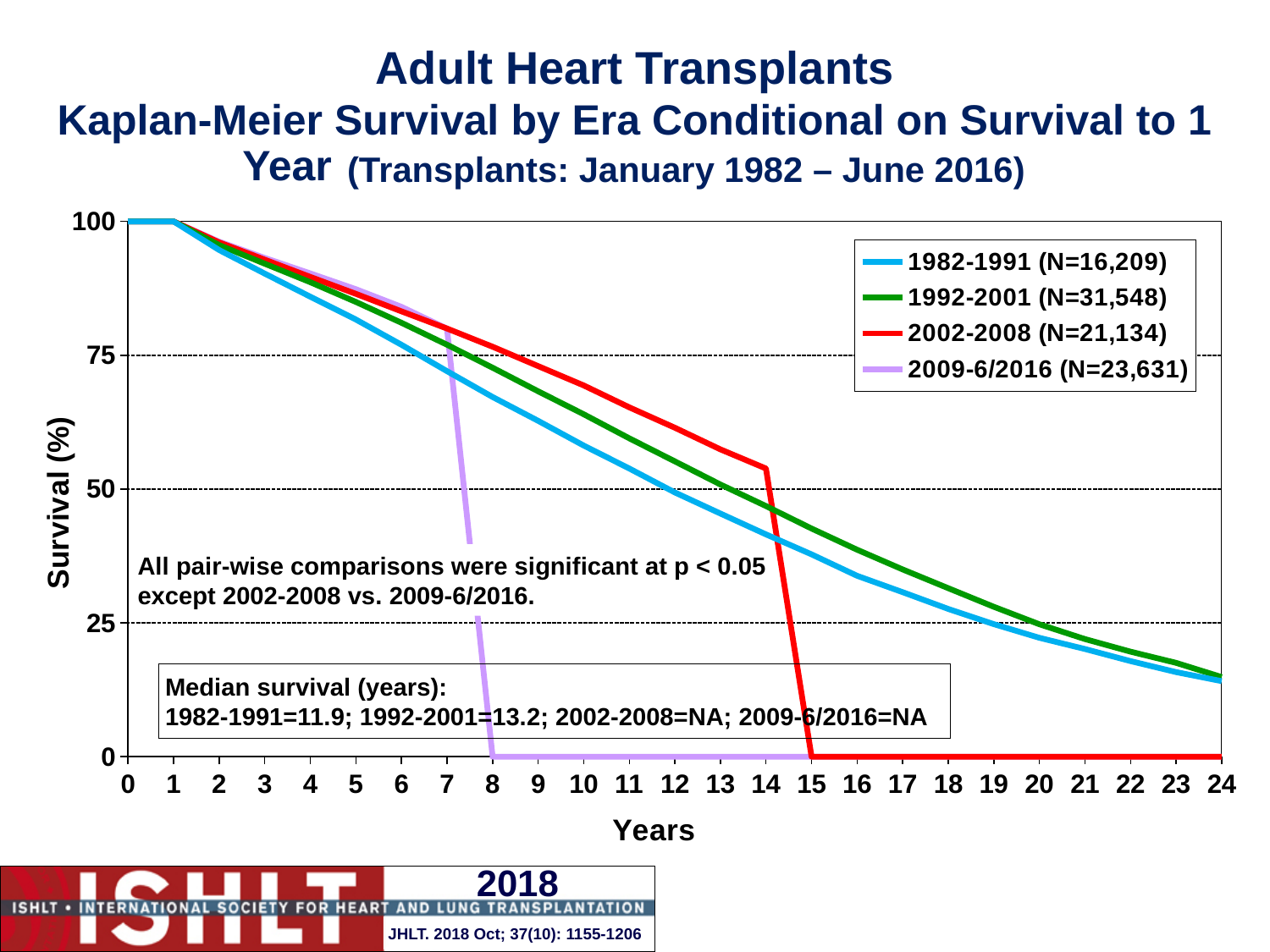
Which era has the largest N in the legend? 1992-2001 (N=31,548) Do the survival curves rise or fall as years increase? fall Is the survival for the 1982-1991 era at year 10 greater or less than 50? greater What is the difference in median survival (years) between the 1992-2001 and 1982-1991 eras? 1.3 According to the legend, what is the N for the 1992-2001 era? N=31,548 What is the median survival listed for the 2002-2008 era? NA At year 5, which era has higher survival, 1982-1991 or 2002-2008? 2002-2008 What kind of chart is shown on the slide? line chart What is the median survival in years for the 1992-2001 era? 13.2 Is the survival for the 1992-2001 era at year 24 greater or less than 25? less What is the median survival in years for the 1982-1991 era? 11.9 How many series (eras) does the legend list? 4